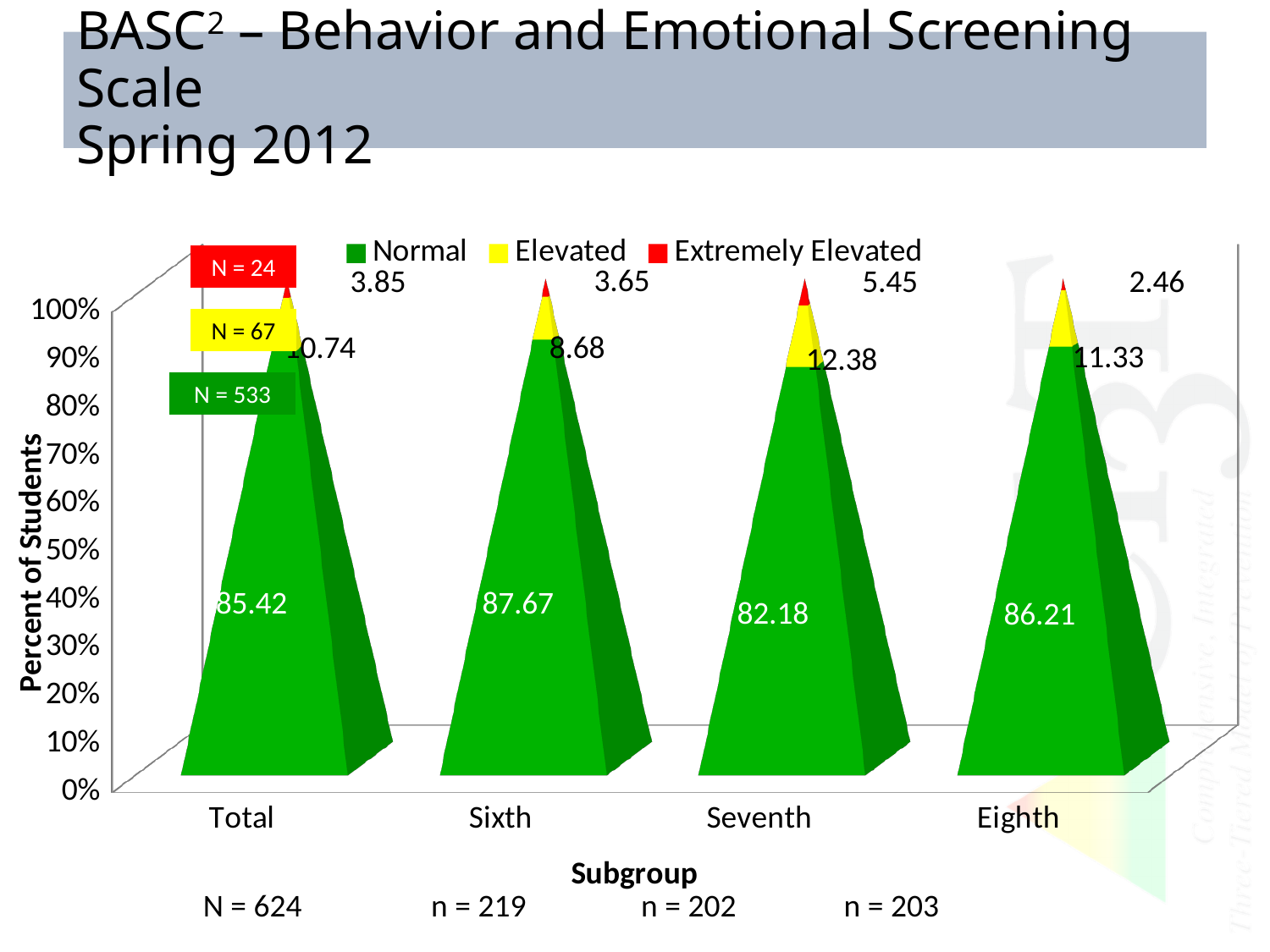
What colour represents the Elevated series in the legend? Yellow How many subgroups are shown on the x axis? 4 Which has the larger Elevated value, Sixth or Seventh? Seventh What is the difference between the Normal values for Sixth and Seventh? 5.49 Which subgroup has the lowest Normal value? Seventh Which subgroup has the lowest Extremely Elevated value? Eighth How many series does the legend list? 3 Which subgroup has the highest Extremely Elevated value? Seventh What is the Elevated value for the Eighth subgroup? 11.33 What is the Normal value for the Seventh subgroup? 82.18 What is the Extremely Elevated value for the Sixth subgroup? 3.65 Which subgroup has the highest Normal value? Sixth